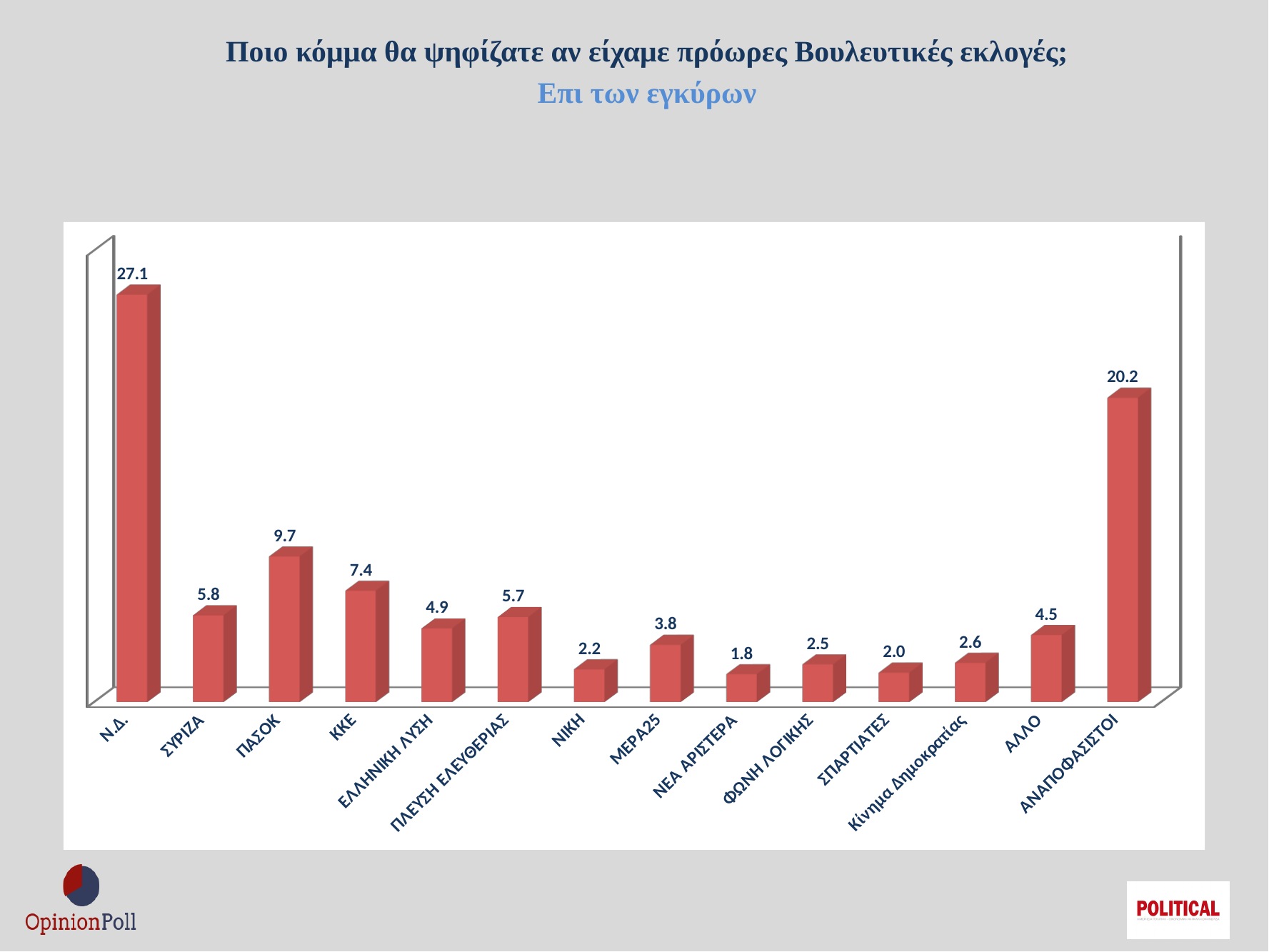
How many categories are shown on the chart? 14 What kind of chart is shown on the slide? Bar chart Which category has the highest value? Ν.Δ. What is the value for Κίνημα Δημοκρατίας? 2.6 What is the value for ΠΑΣΟΚ? 9.7 What is the value for Ν.Δ.? 27.1 Which category has the lowest value? ΝΕΑ ΑΡΙΣΤΕΡΑ What is the difference between the values for ΠΑΣΟΚ and ΚΚΕ? 2.3 What is the difference between the values for Ν.Δ. and ΑΝΑΠΟΦΑΣΙΣΤΟΙ? 6.9 Which is larger, the value for ΜΕΡΑ25 or the value for ΑΛΛΟ? ΑΛΛΟ What is the value for ΑΝΑΠΟΦΑΣΙΣΤΟΙ? 20.2 Which is larger, the value for ΣΥΡΙΖΑ or the value for ΠΛΕΥΣΗ ΕΛΕΥΘΕΡΙΑΣ? ΣΥΡΙΖΑ